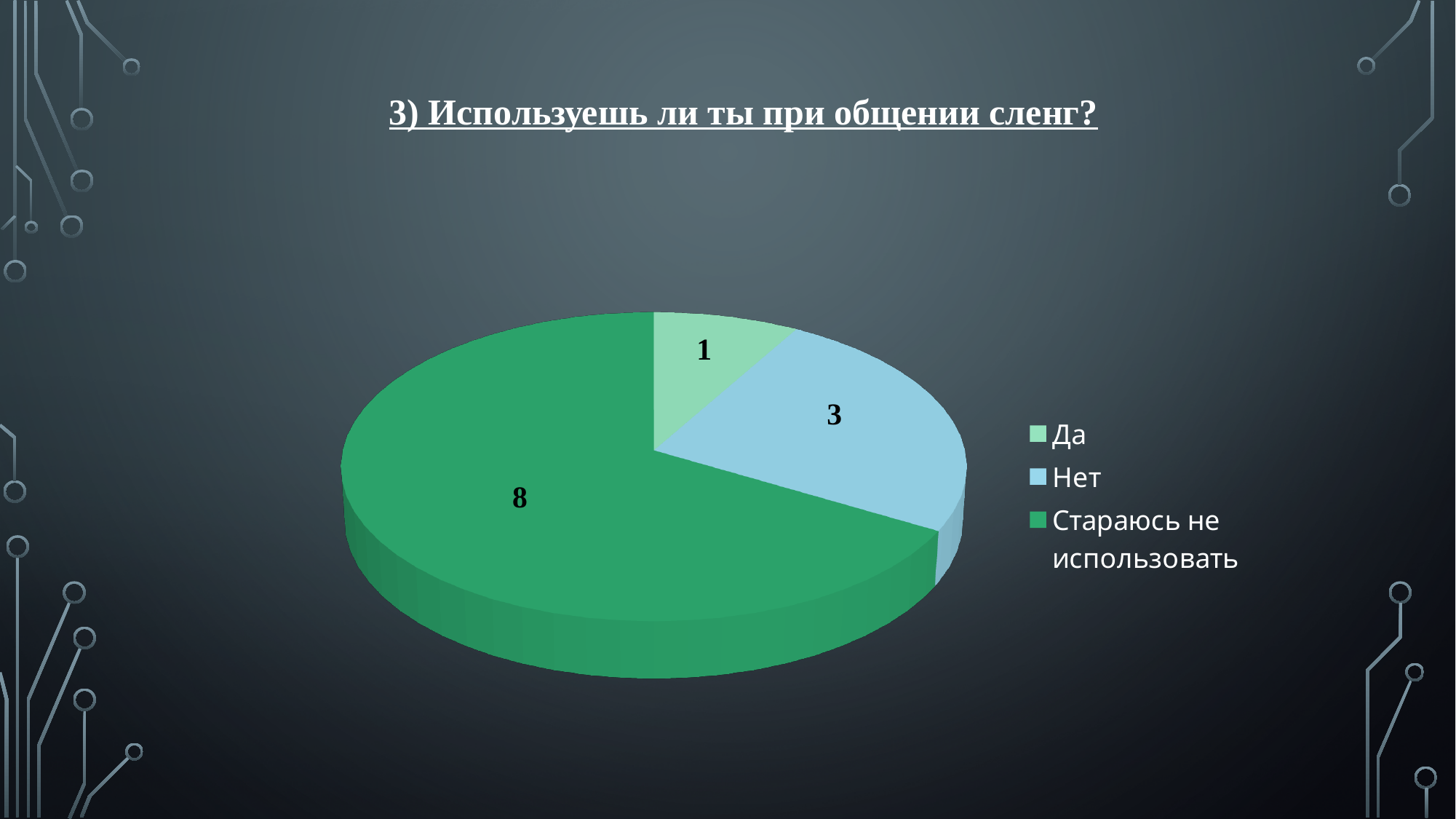
What type of chart is shown on the slide? Pie chart What value is shown for the "Нет" slice? 3 What value is shown for the "Стараюсь не использовать" slice? 8 Which category has the largest slice of the pie? Стараюсь не использовать What is the total of all the values in the pie chart? 12 How many categories does the pie chart have? 3 Which is larger, the value for "Нет" or the value for "Да"? Нет Which category has the smallest slice of the pie? Да What share of the pie does the "Нет" slice represent? 25% What is the difference between the values for "Стараюсь не использовать" and "Нет"? 5 What value is shown for the "Да" slice? 1 What is the difference between the values for "Нет" and "Да"? 2